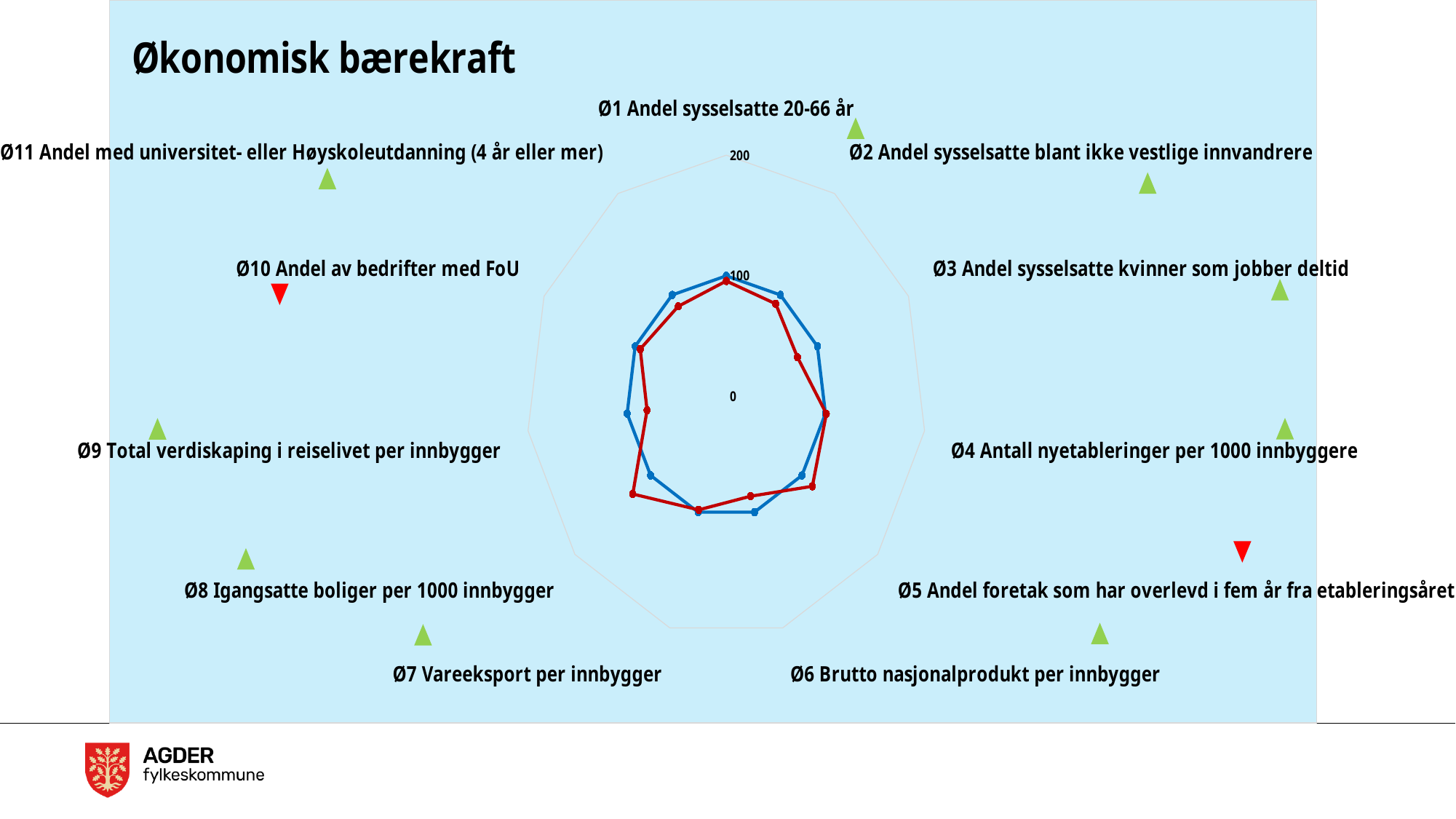
Is the red series value for Ø9 Total verdiskaping i reiselivet per innbygger greater or less than 100? less For Ø3 Andel sysselsatte kvinner som jobber deltid, which series has the larger value, blue or red? Blue How many indicator axes (categories) does the radar chart have? 11 On which indicator does the red series reach its highest value? Ø8 Igangsatte boliger per 1000 innbygger Is the red series value for Ø8 Igangsatte boliger per 1000 innbygger greater or less than 100? greater What kind of chart is shown on the slide? Radar chart What is the title of the slide containing the radar chart? Økonomisk bærekraft How many data series are plotted on the radar chart? 2 For Ø8 Igangsatte boliger per 1000 innbygger, which series has the larger value, blue or red? Red What is the highest value shown on the radar chart's scale? 200